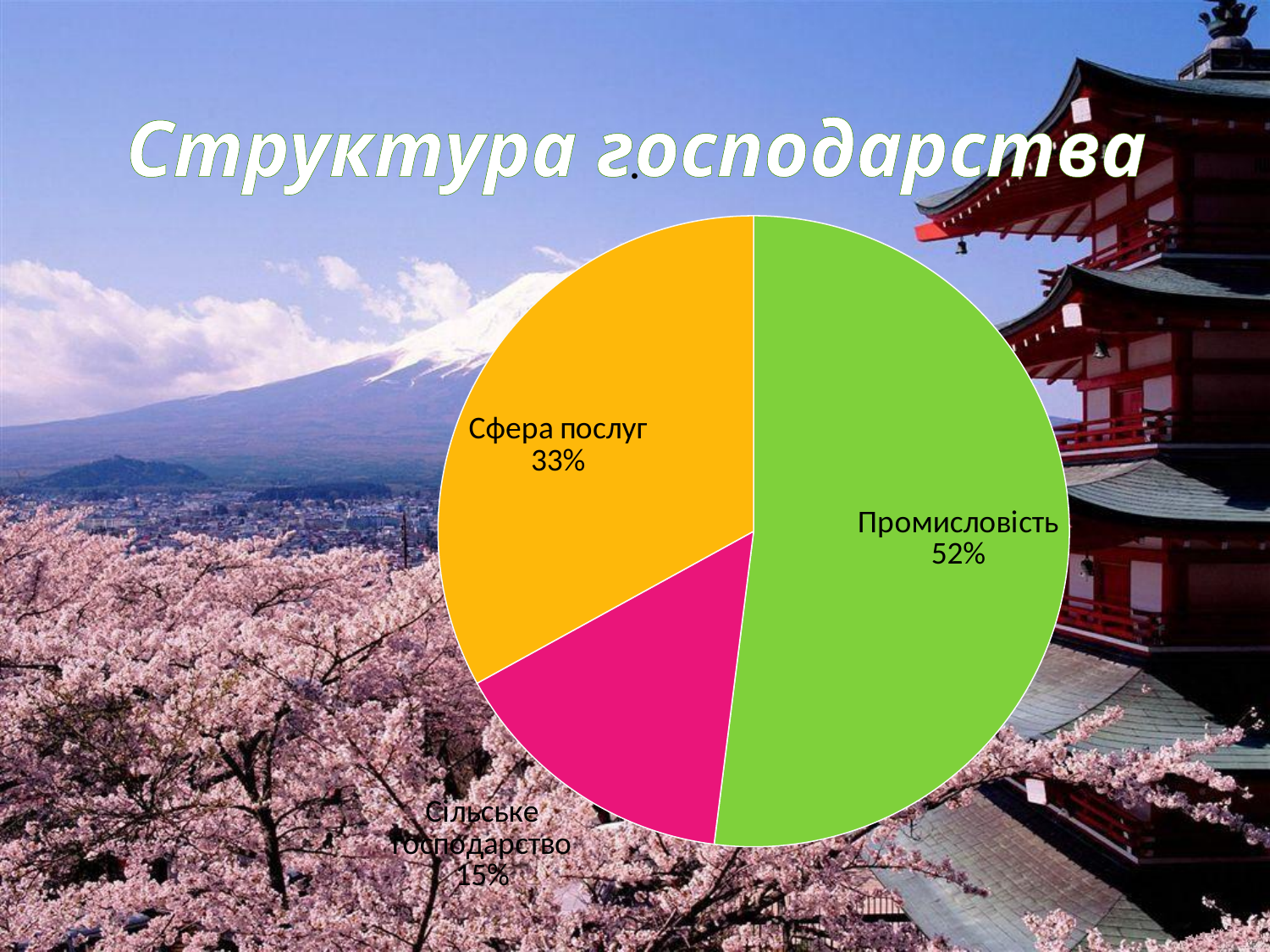
What is the difference in percentage points between Сфера послуг and Сільське господарство? 18 Which slice of the pie is the smallest? Сільське господарство Which slice of the pie is the largest? Промисловість What share of the pie does Сфера послуг have? 33% What colour is the Промисловість slice of the pie? green How many slices does the pie chart have? 3 What share of the pie does Промисловість have? 52% What kind of chart is shown on the slide? pie chart What is the title of the slide containing the pie chart? Структура господарства What share of the pie does Сільське господарство have? 15% What is the difference in percentage points between Промисловість and Сфера послуг? 19 Which is larger, the share for Сфера послуг or the share for Сільське господарство? Сфера послуг